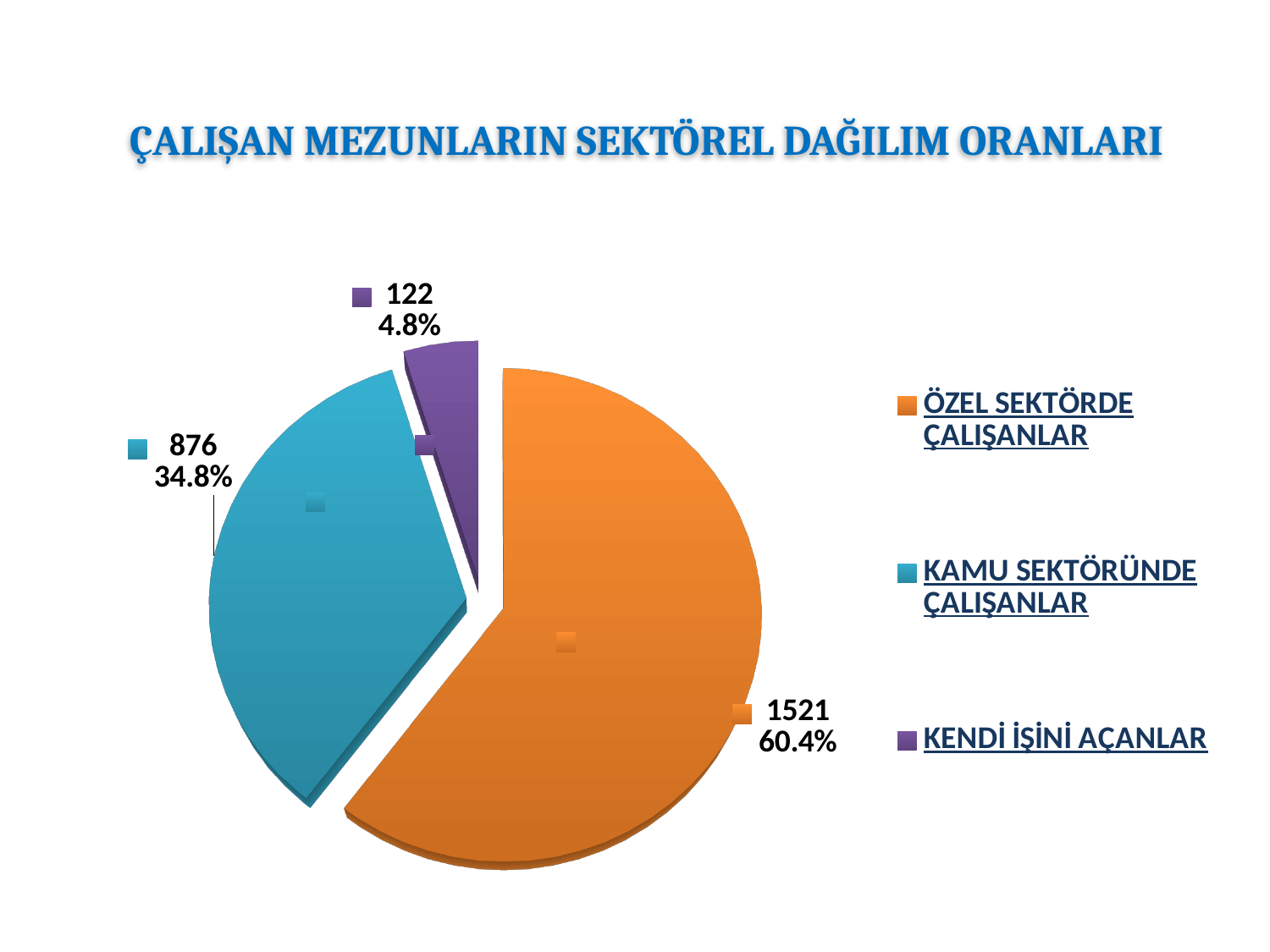
How many categories does the pie chart have? 3 What is the difference between the values for ÖZEL SEKTÖRDE ÇALIŞANLAR and KAMU SEKTÖRÜNDE ÇALIŞANLAR? 645 What share of the pie does KENDİ İŞİNİ AÇANLAR represent? 4.8% What is the value for KAMU SEKTÖRÜNDE ÇALIŞANLAR? 876 What share of the pie does KAMU SEKTÖRÜNDE ÇALIŞANLAR represent? 34.8% Which is larger, the value for KAMU SEKTÖRÜNDE ÇALIŞANLAR or KENDİ İŞİNİ AÇANLAR? KAMU SEKTÖRÜNDE ÇALIŞANLAR What is the value for ÖZEL SEKTÖRDE ÇALIŞANLAR? 1521 Which category has the smallest slice? KENDİ İŞİNİ AÇANLAR Which category has the largest slice? ÖZEL SEKTÖRDE ÇALIŞANLAR What is the title of the chart? ÇALIŞAN MEZUNLARIN SEKTÖREL DAĞILIM ORANLARI What kind of chart is shown on the slide? pie chart What is the value for KENDİ İŞİNİ AÇANLAR? 122